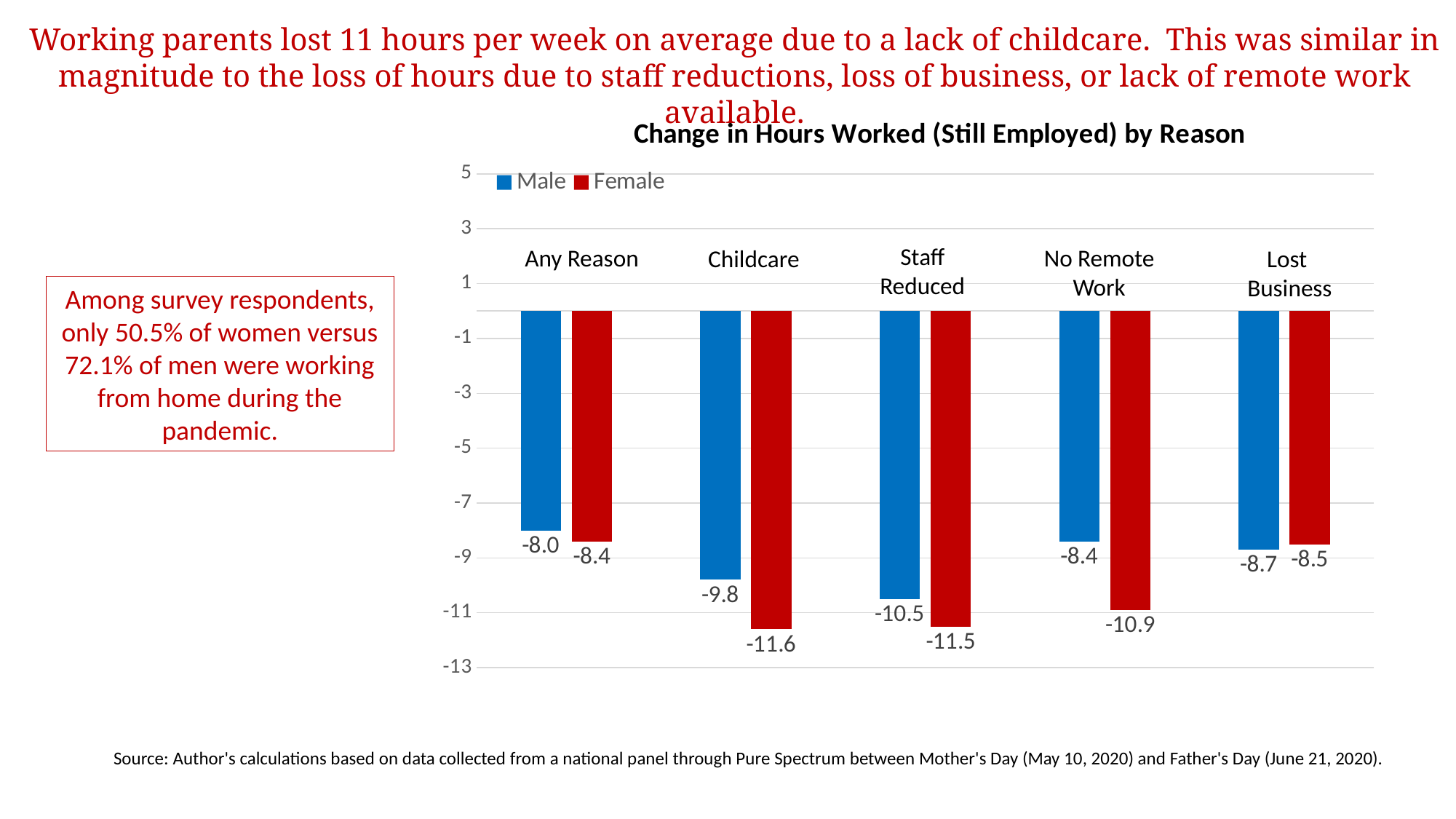
Which category has the lowest Female value? Childcare What is the Female value for Any Reason? -8.4 How many categories are shown on the x axis? 5 What is the title of the chart? Change in Hours Worked (Still Employed) by Reason Which is larger, the Male value for Lost Business or the Female value for Lost Business? Female (-8.5) Which category has the lowest Male value? Staff Reduced Which category has the highest Male value? Any Reason What is the Female value for No Remote Work? -10.9 What is the difference between the Female and Male values for Childcare? 1.8 How many series does the legend list? 2 What kind of chart is shown? Bar chart What is the Male value for Childcare? -9.8